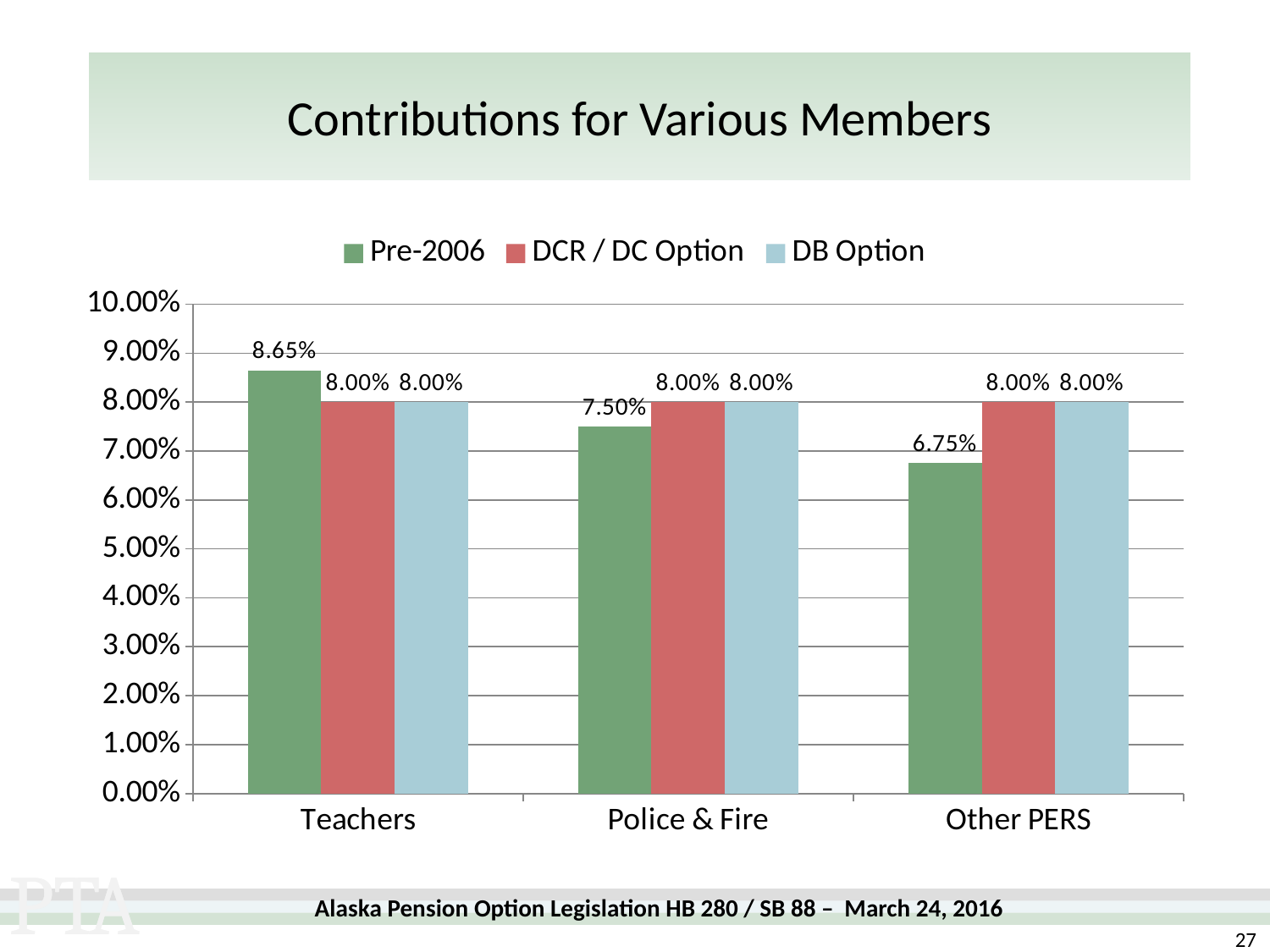
Which member group has the highest Pre-2006 contribution rate? Teachers What is the Pre-2006 contribution rate for Teachers? 8.65% What is the Pre-2006 contribution rate for Other PERS? 6.75% What is the DCR / DC Option contribution rate for Police & Fire? 8.00% What is the difference between the Pre-2006 rate and the DB Option rate for Police & Fire? 0.50% Is the Pre-2006 value for Other PERS greater or less than 7.00%? less Which is larger for Teachers: the Pre-2006 rate or the DB Option rate? Pre-2006 Which member group has the lowest Pre-2006 contribution rate? Other PERS How many member groups are shown on the x axis? 3 How many series does the legend list? 3 What is the difference between the Pre-2006 rate for Teachers and the Pre-2006 rate for Other PERS? 1.90% What kind of chart is shown on the slide? Bar chart